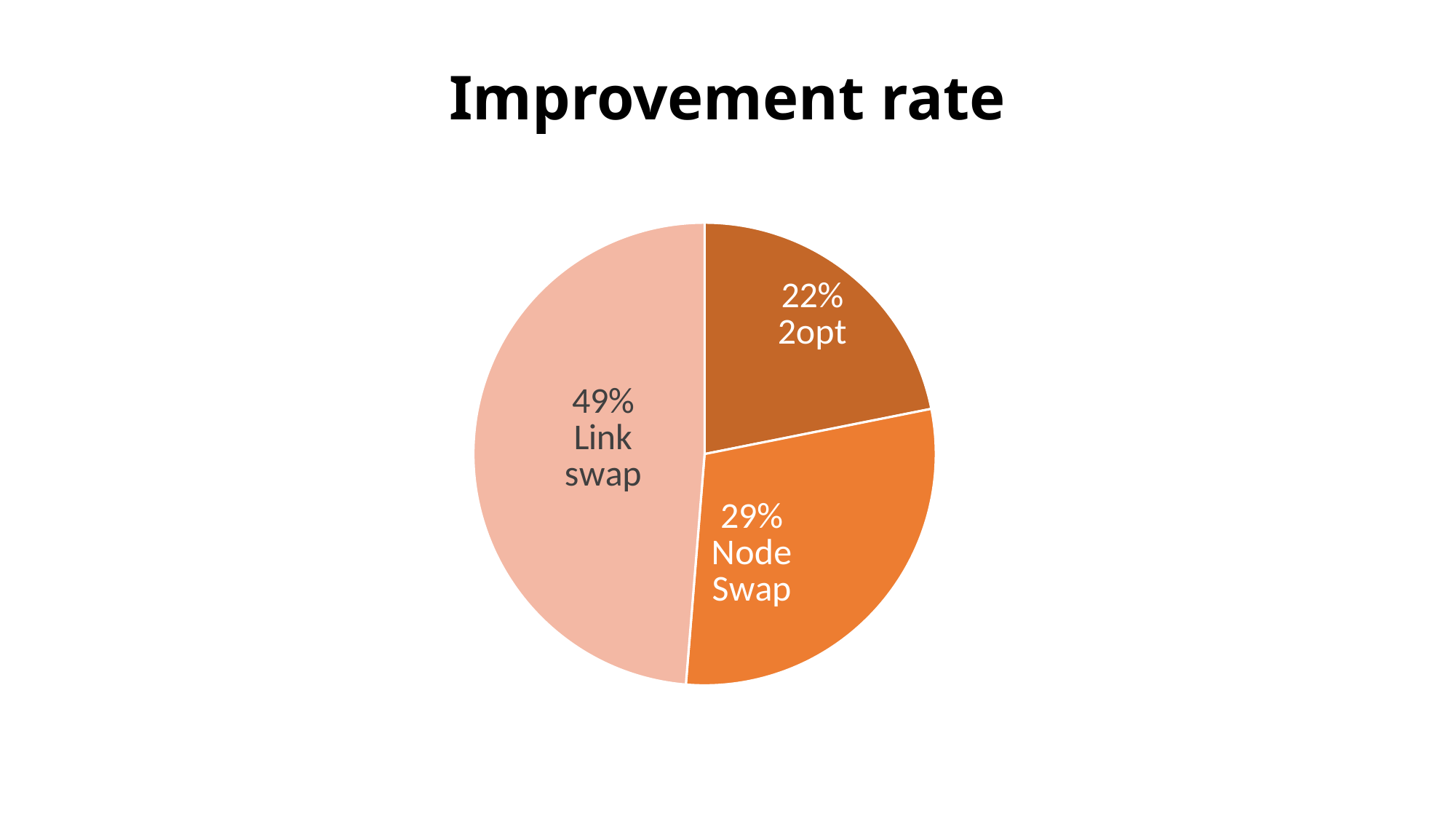
What kind of chart is shown on the slide? pie chart What is the difference between the Link swap share and the Node Swap share? 20% What share of the pie does Node Swap have? 29% What share of the pie does Link swap have? 49% What is the title of the chart? Improvement rate Which is larger, the Node Swap slice or the 2opt slice? Node Swap Which slice is the smallest? 2opt Which slice is the largest? Link swap How many slices does the pie chart have? 3 What share of the pie does 2opt have? 22% What is the difference between the Node Swap share and the 2opt share? 7% Which slice is shown in the lightest colour? Link swap